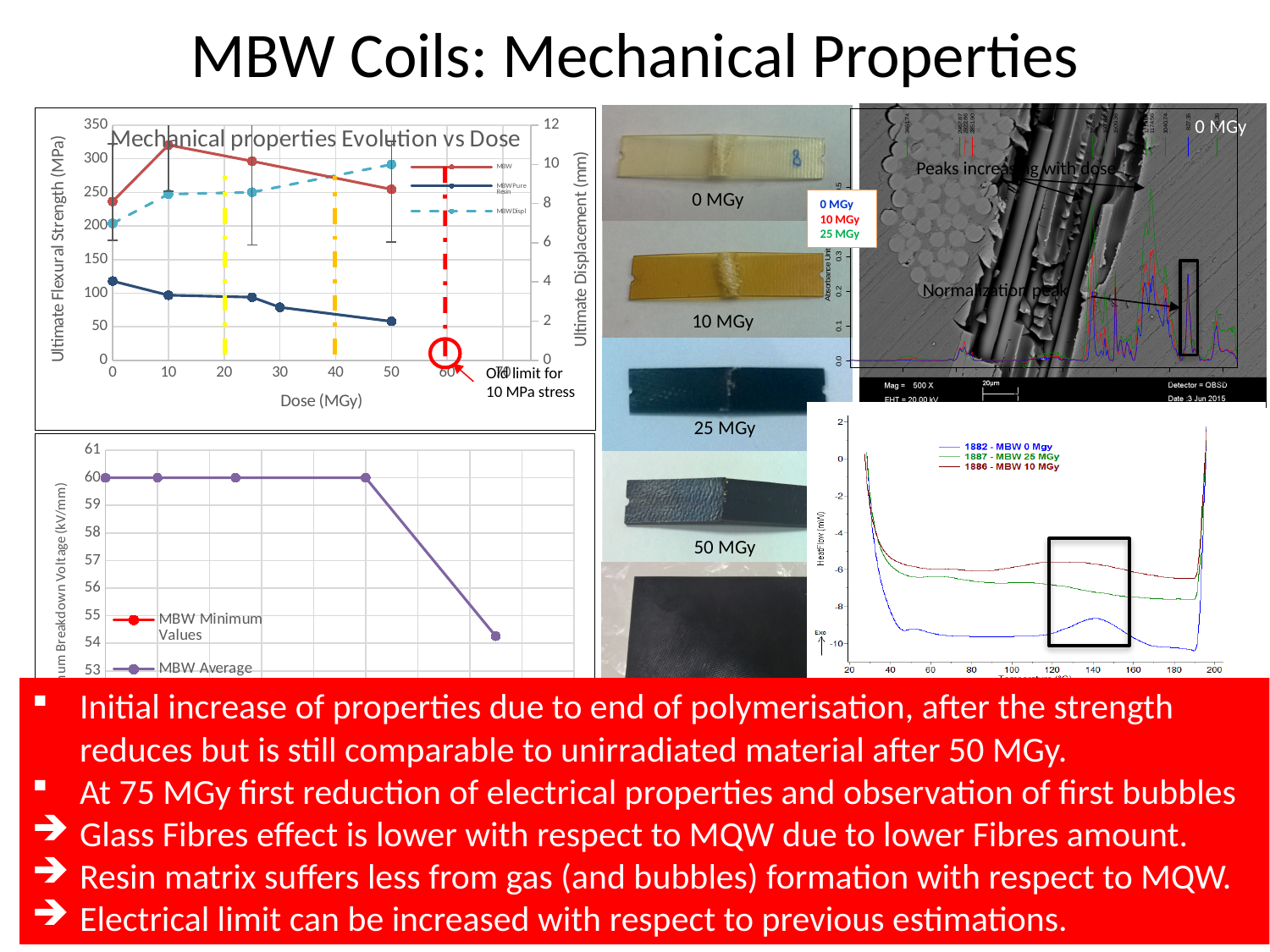
In the 'Mechanical properties Evolution vs Dose' chart, at which dose does the MBW series reach its highest flexural strength? 10 MGy In the 'Mechanical properties Evolution vs Dose' chart, at 0 MGy which is larger: the MBW flexural strength or the MBW Pure Resin flexural strength? MBW In the 'Mechanical properties Evolution vs Dose' chart, is the MBW flexural strength at 10 MGy greater or less than 300 MPa? greater How many series does the legend of the 'Mechanical properties Evolution vs Dose' chart list? 3 What kind of chart is the 'Mechanical properties Evolution vs Dose' chart? line chart In the 'Mechanical properties Evolution vs Dose' chart, is the MBW Pure Resin flexural strength at 50 MGy greater or less than 100 MPa? less In the 'Mechanical properties Evolution vs Dose' chart, is the MBW Displ value at 50 MGy greater or less than 8 mm? greater In the 'Mechanical properties Evolution vs Dose' chart, does the MBW Pure Resin series rise or fall as dose increases? falls What is the x-axis label of the 'Mechanical properties Evolution vs Dose' chart? Dose (MGy) How many series does the legend of the breakdown voltage chart at the bottom left list? 2 In the breakdown voltage chart at the bottom left, does the MBW Average line rise or fall at its right end? falls